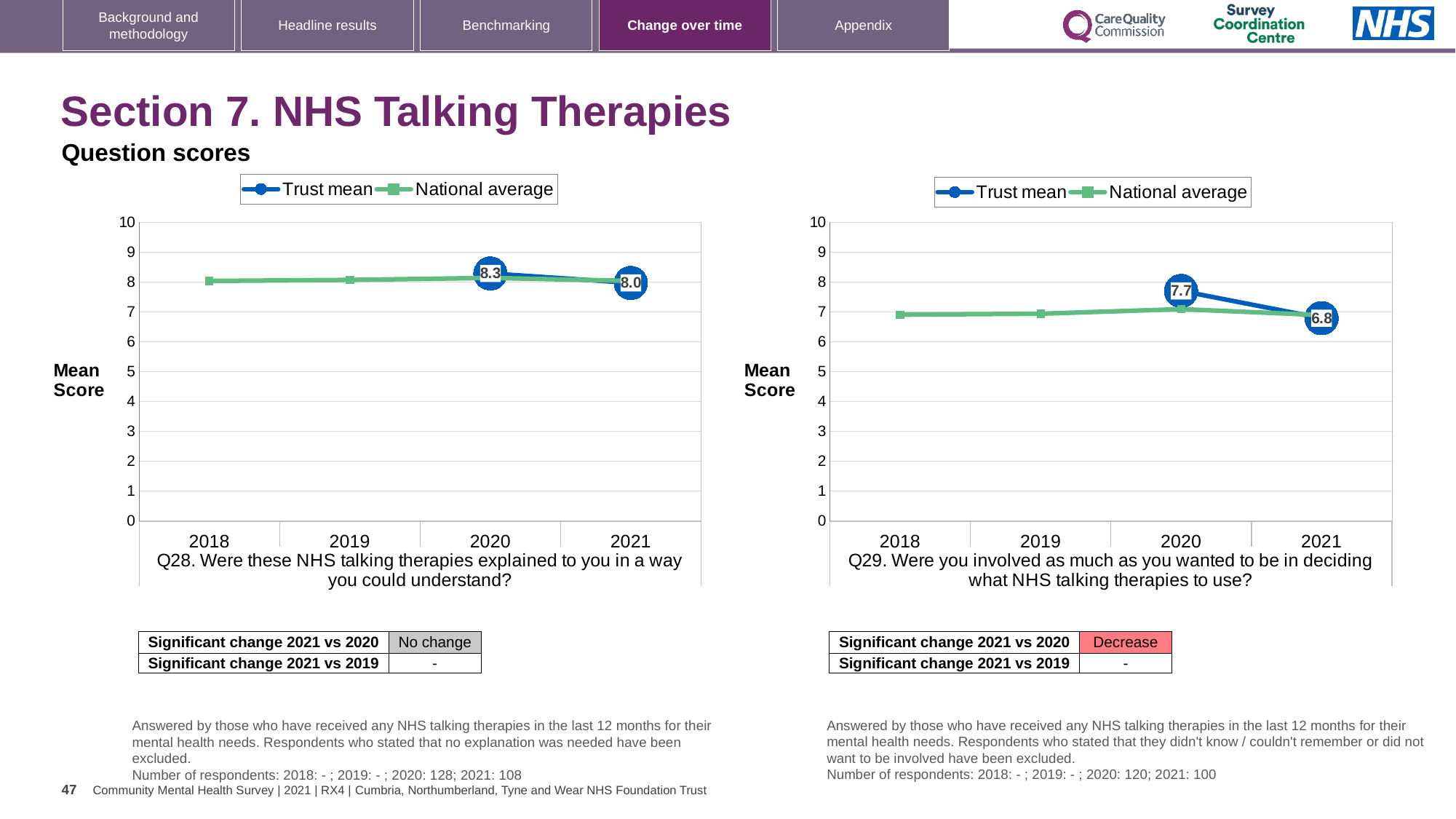
What kind of chart is the right chart (Q29)? line chart In the right chart (Q29), what is the Trust mean for 2020? 7.7 In the right chart (Q29), does the Trust mean rise or fall from 2020 to 2021? fall How many series does the legend of the left chart (Q28) list? 2 In the left chart (Q28), is the National average for 2018 greater or less than 9? less In the right chart (Q29), is the National average for 2019 greater or less than 8? less In the left chart (Q28), what is the Trust mean for 2021? 8.0 In the right chart (Q29), what is the Trust mean for 2021? 6.8 In the right chart (Q29), what is the difference between the Trust mean in 2020 and in 2021? 0.9 In the left chart (Q28), what is the Trust mean for 2020? 8.3 In the right chart (Q29), which year has the higher Trust mean, 2020 or 2021? 2020 In the left chart (Q28), what is the difference between the Trust mean in 2020 and in 2021? 0.3